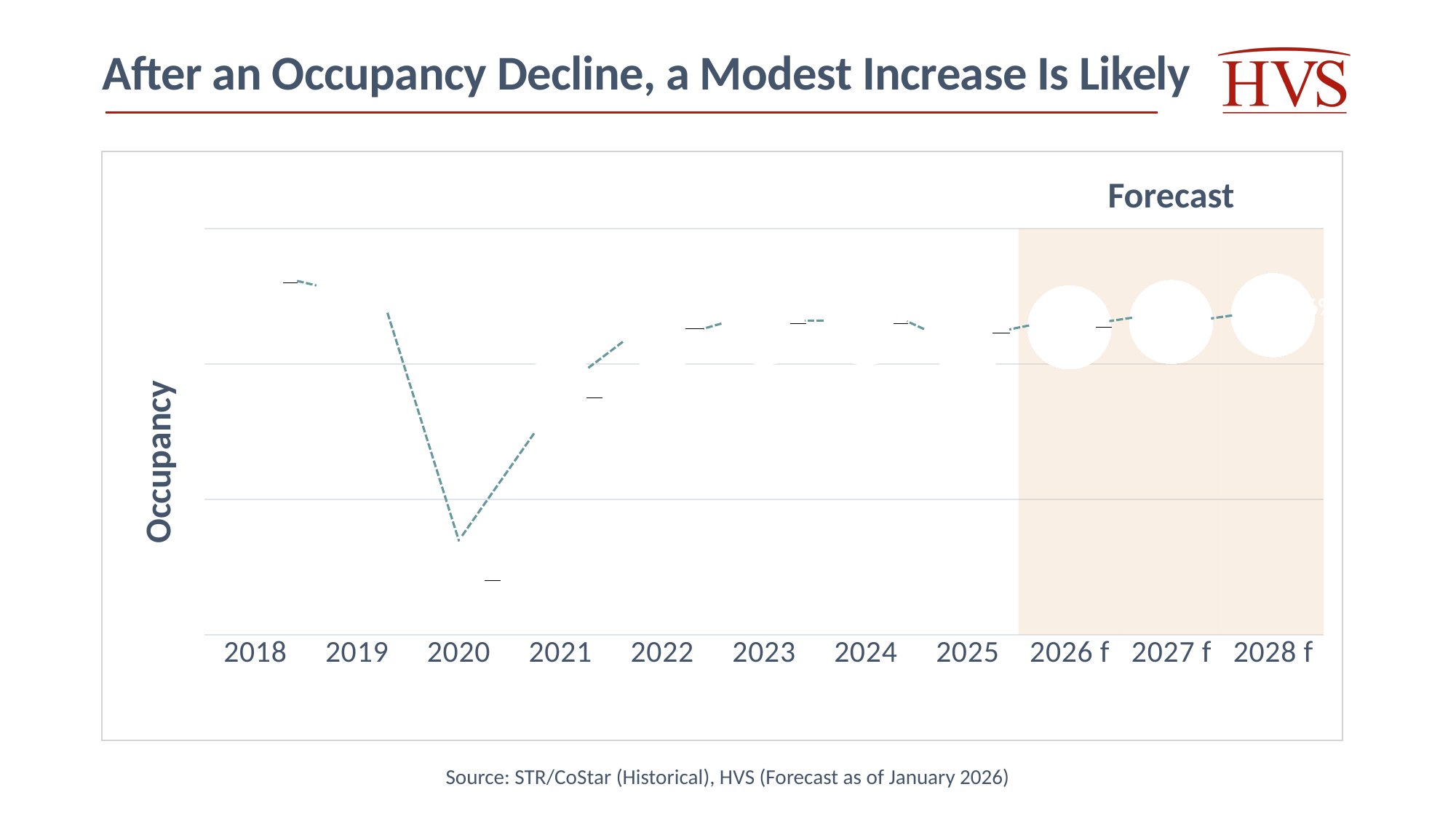
What is the label on the y axis of the chart? Occupancy Which year has the highest occupancy in the chart? 2018 How many years are shown along the x axis of the chart? 11 What kind of chart is shown on the slide? line chart What is the title of the slide? After an Occupancy Decline, a Modest Increase Is Likely Is occupancy higher in 2021 or in 2020? 2021 Which year has the lowest occupancy in the chart? 2020 How many years on the x axis are marked as forecast with an 'f'? 3 Does occupancy rise or fall from 2025 to 2028 f? rise Does occupancy rise or fall from 2019 to 2020? fall Is occupancy higher in 2018 or in 2020? 2018 Does occupancy rise or fall from 2020 to 2021? rise